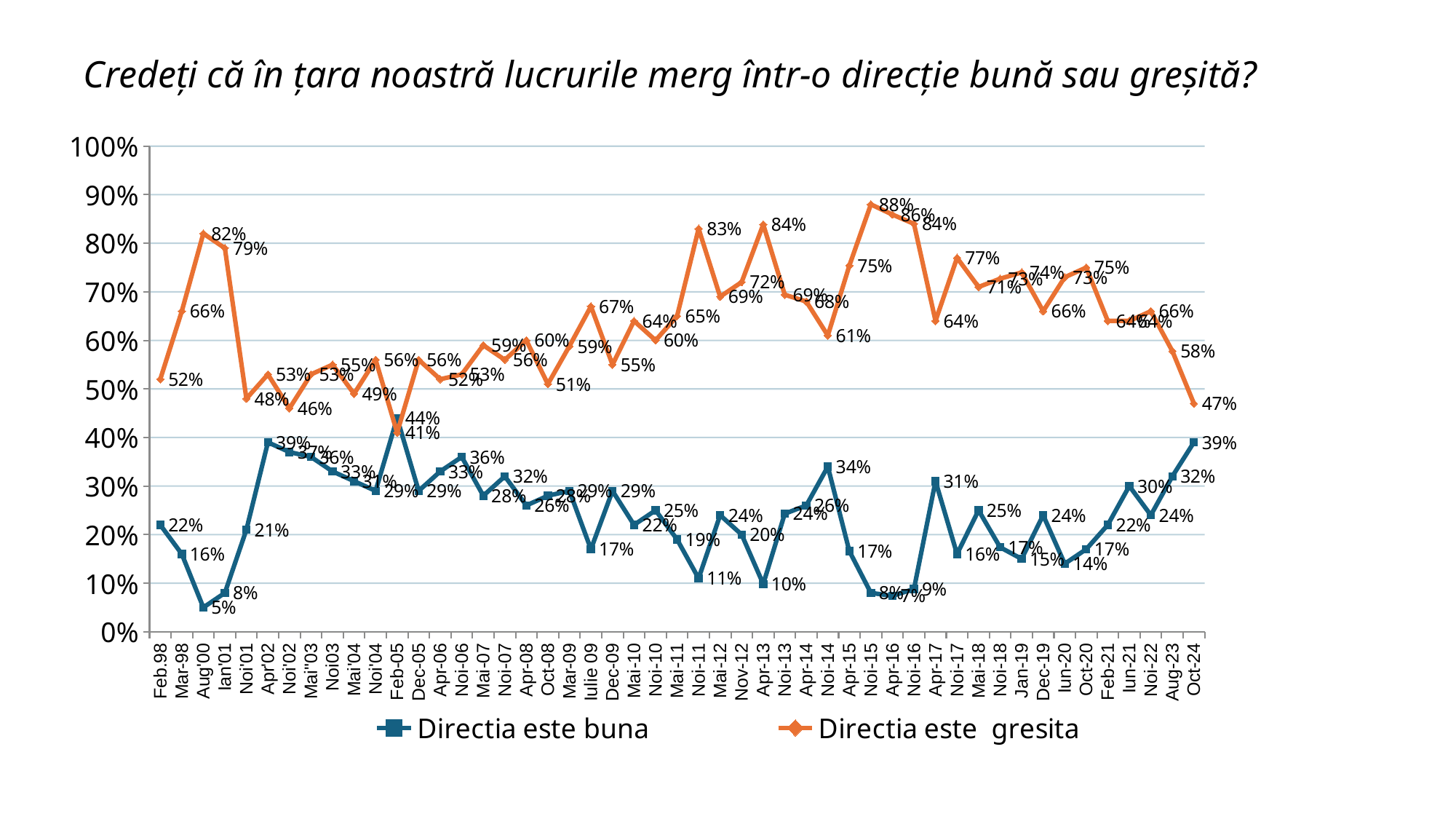
At which date does 'Directia este gresita' reach its lowest value? Feb-05 What is the value of 'Directia este buna' for Oct-24? 39% What type of chart is shown on the slide? line chart How many series does the legend list? 2 At which date does 'Directia este gresita' reach its highest value? Noi-15 What is the value of 'Directia este gresita' for Noi-15? 88% Which series has the larger value for Feb-05? Directia este buna What is the difference between 'Directia este gresita' and 'Directia este buna' for Oct-24? 8% What is the difference between the 'Directia este gresita' values for Aug-23 and Oct-24? 11% What is the value of 'Directia este gresita' for Oct-24? 47% At which date does 'Directia este buna' reach its lowest value? Aug'00 What is the title of the chart? Credeți că în țara noastră lucrurile merg într-o direcție bună sau greșită?